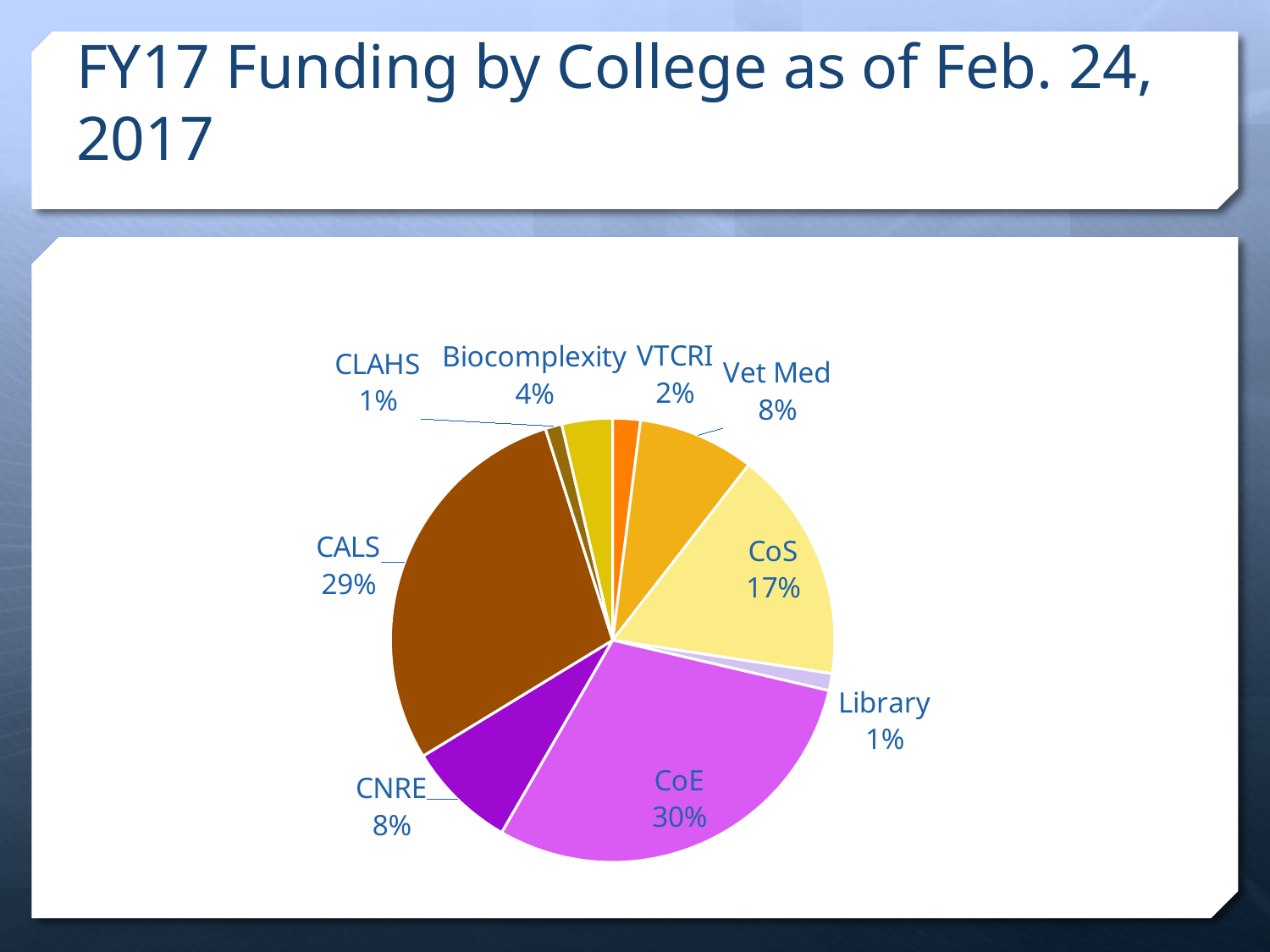
What share of FY17 funding does CALS have? 29% What share of FY17 funding does CoE have? 30% How many slices does the pie chart have? 9 What is the combined share of CNRE and Vet Med? 16% What is the difference in percentage points between CoE and CoS? 13 Which has a larger share, Vet Med or CoS? CoS What kind of chart is shown on the slide? pie chart What percentage is shown for Biocomplexity? 4% What percentage is shown for CoS? 17% What percentage is shown for VTCRI? 2% What is the title of the chart on the slide? FY17 Funding by College as of Feb. 24, 2017 Which college has the largest share of FY17 funding? CoE